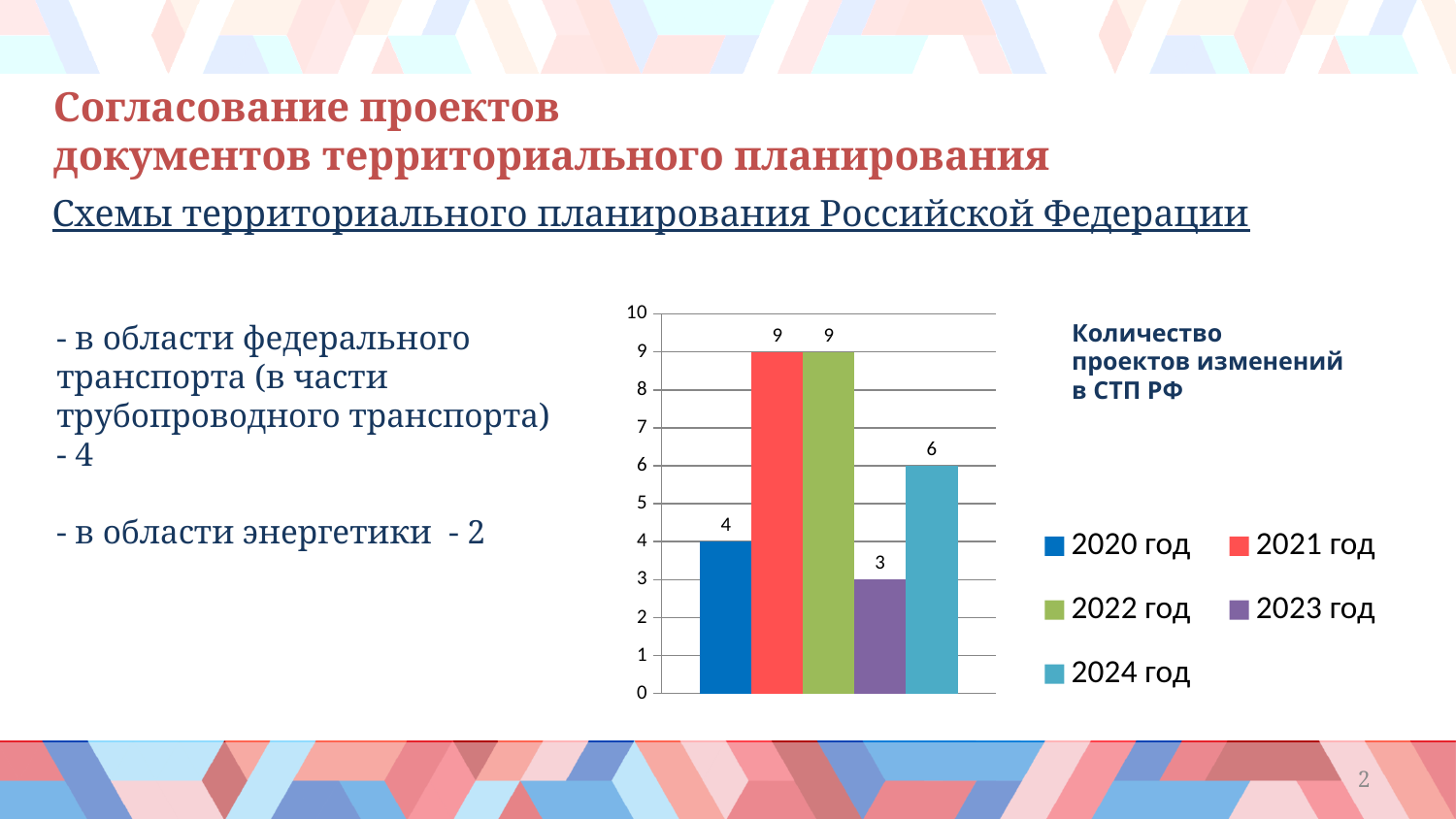
What is the difference between the values for 2024 год and 2020 год? 2 What is the difference between the values for 2022 год and 2023 год? 6 What is the title of the chart? Количество проектов изменений в СТП РФ Is the value for 2021 год greater or less than 5? greater What is the value for 2023 год in the chart? 3 How many series does the legend list? 5 What is the value for 2024 год in the chart? 6 What kind of chart is shown on the slide? bar chart Which is larger, the value for 2020 год or the value for 2024 год? 2024 год What is the value for 2021 год in the chart? 9 Which year has the lowest value in the chart? 2023 год What is the value for 2020 год in the chart? 4